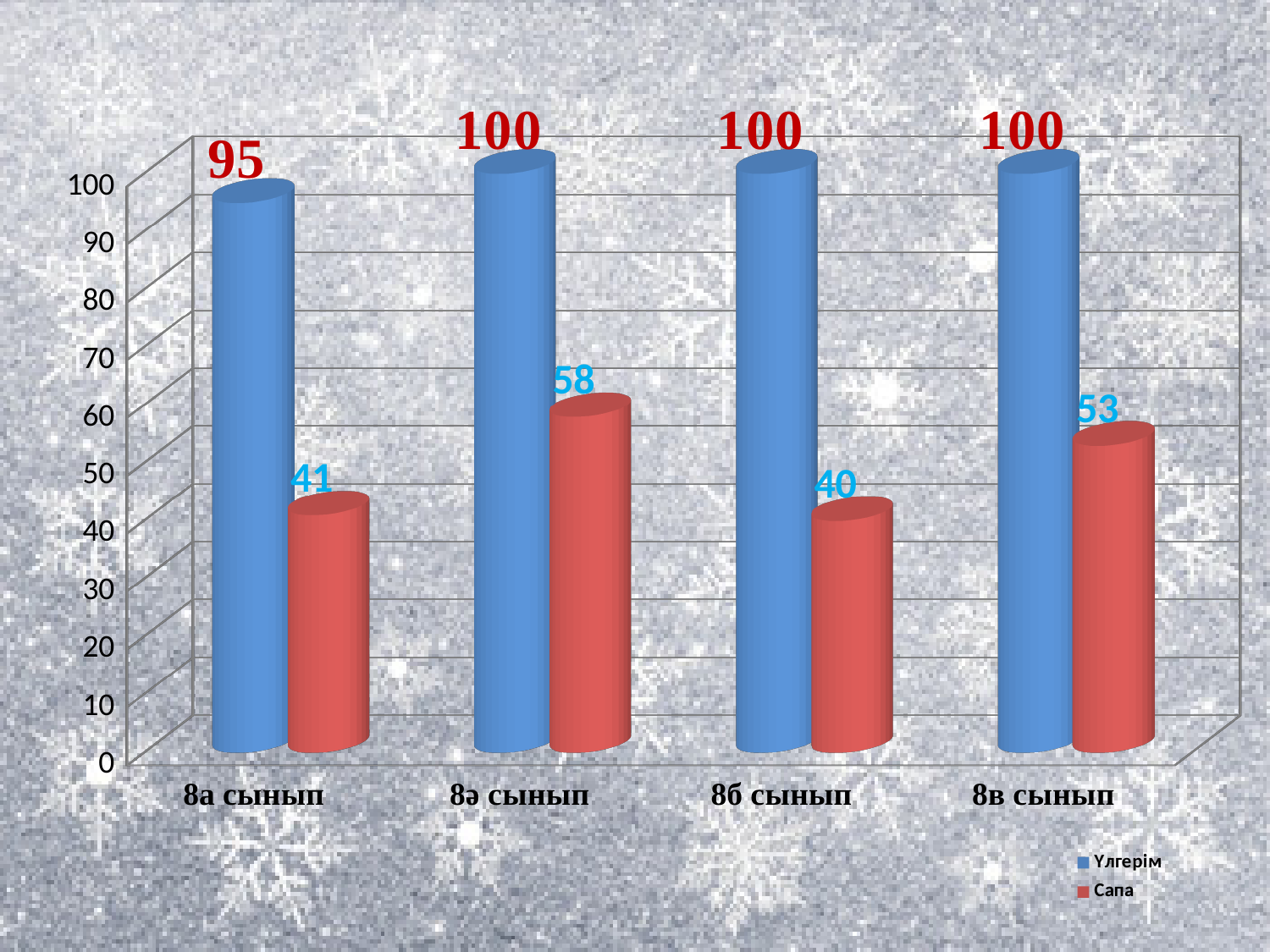
Which series is shown in red? Сапа Which is larger, the Сапа value for 8ә сынып or for 8в сынып? 8ә сынып What is the Сапа value for 8ә сынып? 58 What is the Үлгерім value for 8а сынып? 95 What is the Сапа value for 8б сынып? 40 What is the Сапа value for 8в сынып? 53 Which class has the highest Сапа value? 8ә сынып How many classes are shown on the x axis? 4 Which class has the lowest Үлгерім value? 8а сынып What kind of chart is shown on the slide? bar chart What is the difference between the Үлгерім and Сапа values for 8а сынып? 54 How many series does the legend list? 2